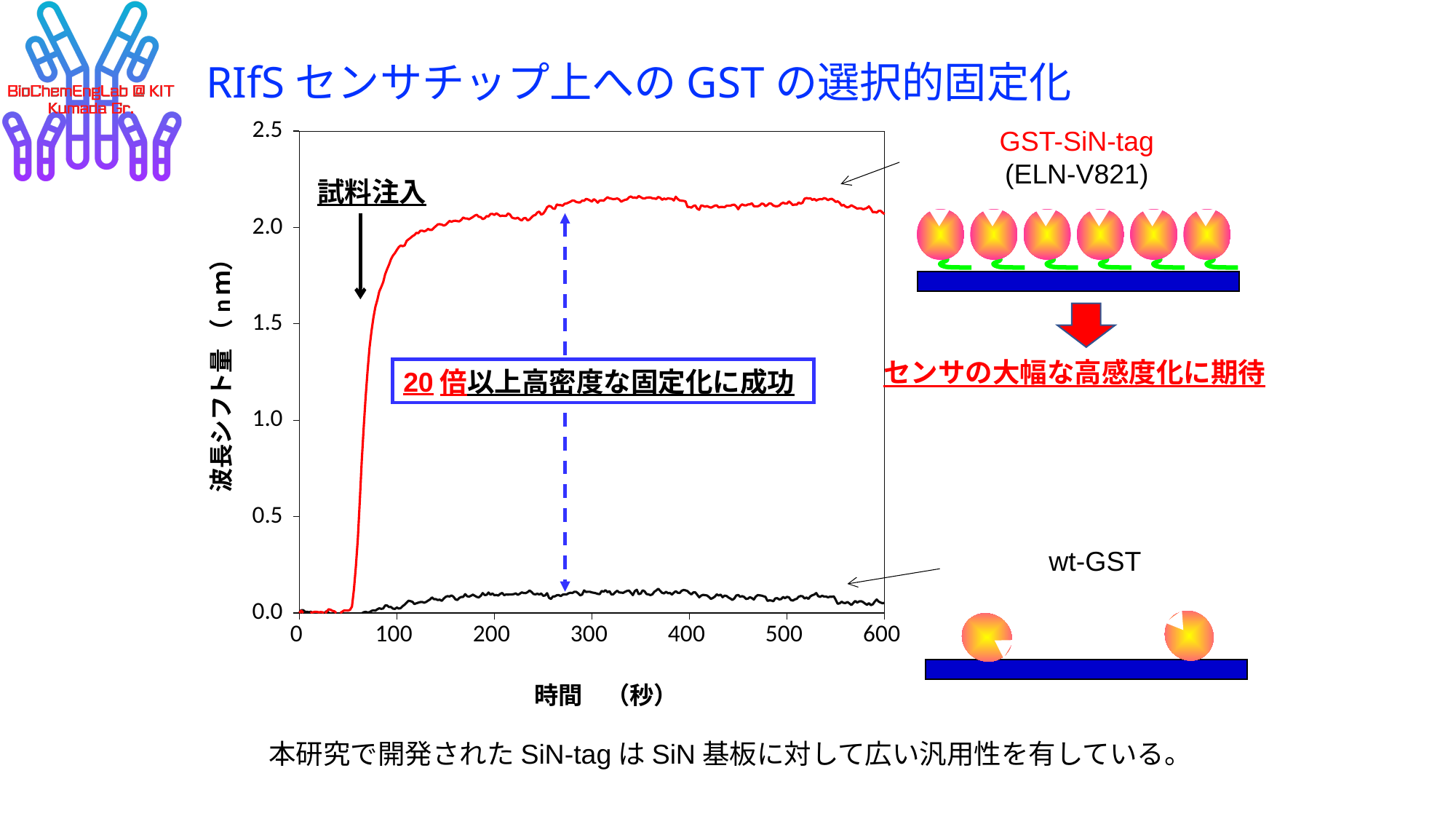
Does the GST-SiN-tag (ELN-V821) curve rise or fall between 50 and 100 seconds? rise What is the maximum value shown on the y axis of the chart? 2.5 What kind of chart is shown on the slide? line chart Which series is drawn in red in the chart? GST-SiN-tag (ELN-V821) What is the maximum value shown on the x axis of the chart? 600 Is the value of the GST-SiN-tag (ELN-V821) curve at 600 seconds greater or less than 1.5 nm? greater Is the value of the GST-SiN-tag (ELN-V821) curve at 0 seconds greater or less than 0.5 nm? less How many data series are plotted in the chart? 2 Is the value of the wt-GST curve at 300 seconds greater or less than 0.5 nm? less Which series reaches the higher wavelength shift, GST-SiN-tag (ELN-V821) or wt-GST? GST-SiN-tag (ELN-V821)